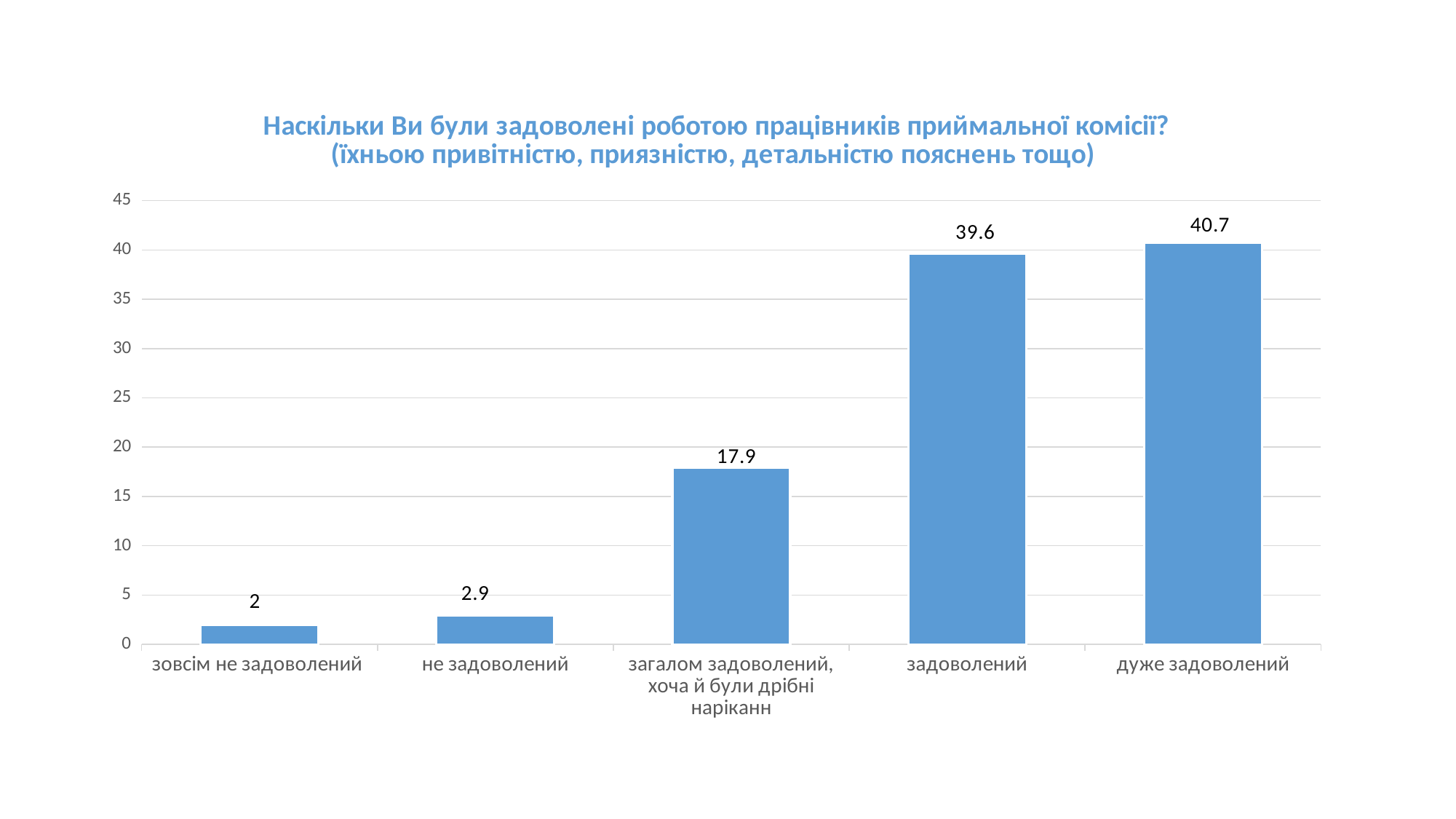
Do the values rise or fall from left to right along the x axis? rise What kind of chart is shown on the slide? bar chart How many categories are shown on the x axis? 5 Which is larger: the value for "не задоволений" or the value for "зовсім не задоволений"? не задоволений What is the difference between the values for "задоволений" and "загалом задоволений, хоча й були дрібні наріканн"? 21.7 Which category has the highest value? дуже задоволений Which category has the lowest value? зовсім не задоволений Is the value for "задоволений" greater or less than 35? greater What is the value for "зовсім не задоволений"? 2 What is the value for "дуже задоволений"? 40.7 What is the value for "загалом задоволений, хоча й були дрібні наріканн"? 17.9 What is the value for "не задоволений"? 2.9